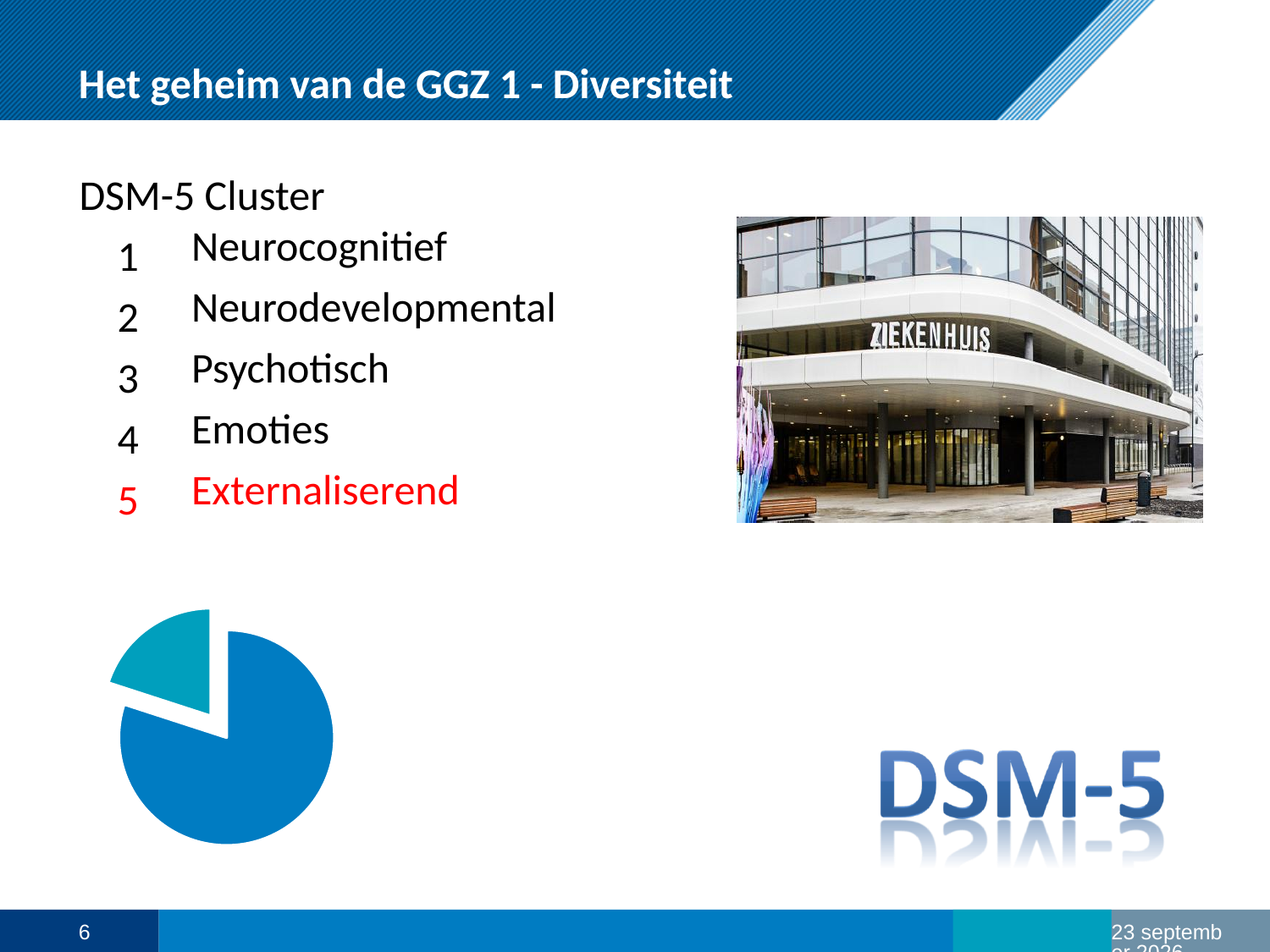
Which slice of the pie chart is pulled out (exploded) from the rest of the pie? the teal slice Does the dark blue slice cover more or less than half of the pie chart? more What kind of chart is shown at the bottom left of the slide? pie chart How many slices does the pie chart have? 2 Which slice of the pie chart is larger, the dark blue one or the teal one? the dark blue one Does the pie chart have a legend? No Which slice of the pie chart is the smallest? the teal slice